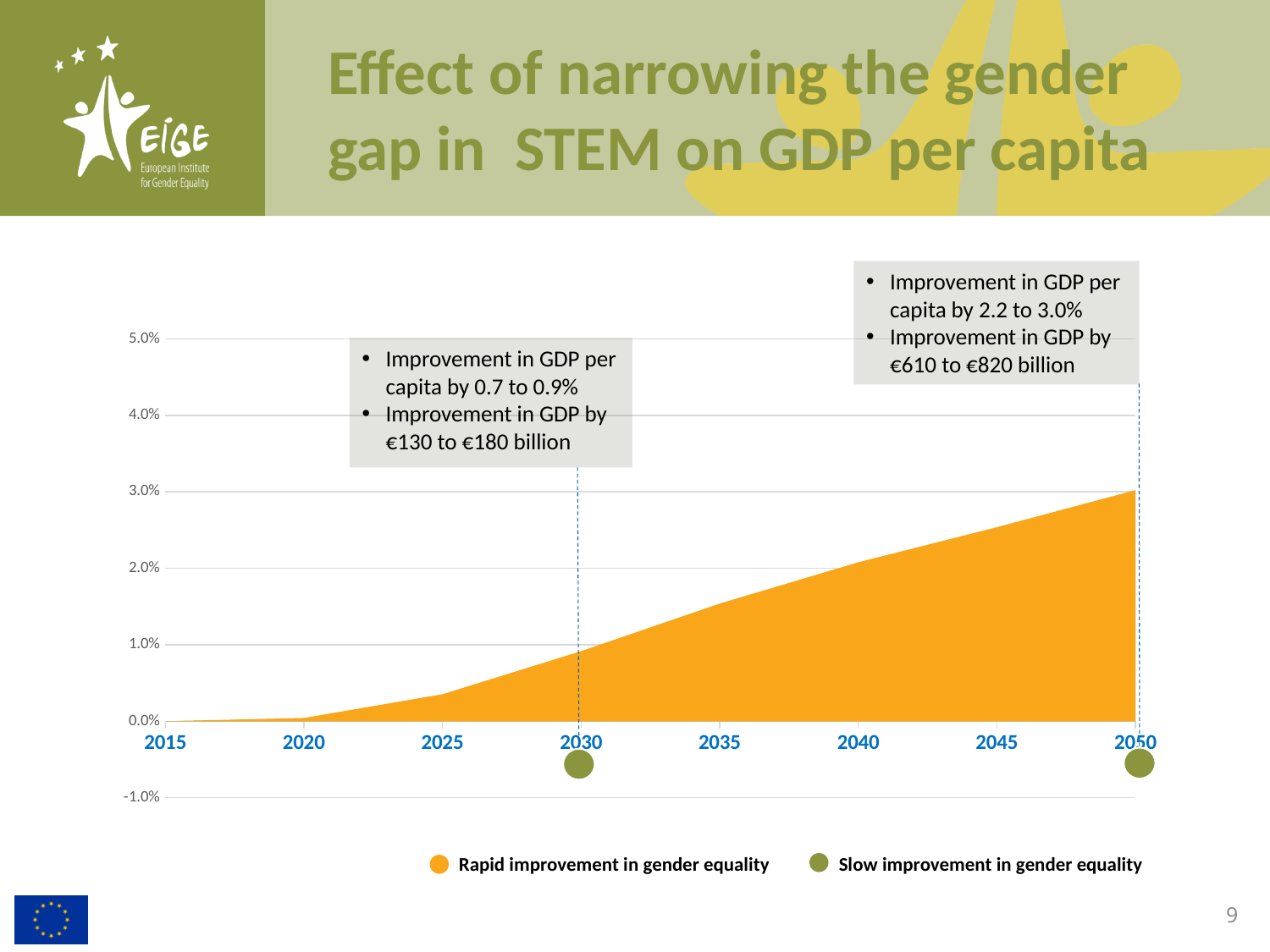
Which legend entry is shown in orange? Rapid improvement in gender equality Is the value for 2050 greater or less than 2.0%? greater How many entries does the legend list? 2 Is the value for 2045 greater or less than 3.0%? less Is the value for 2030 greater or less than 2.0%? less Does the plotted value rise or fall from 2015 to 2050? rise What kind of chart is shown on the slide? area chart In which year shown on the x axis is the plotted value lowest? 2015 How many year labels are shown on the x axis? 8 In which year shown on the x axis is the plotted value highest? 2050